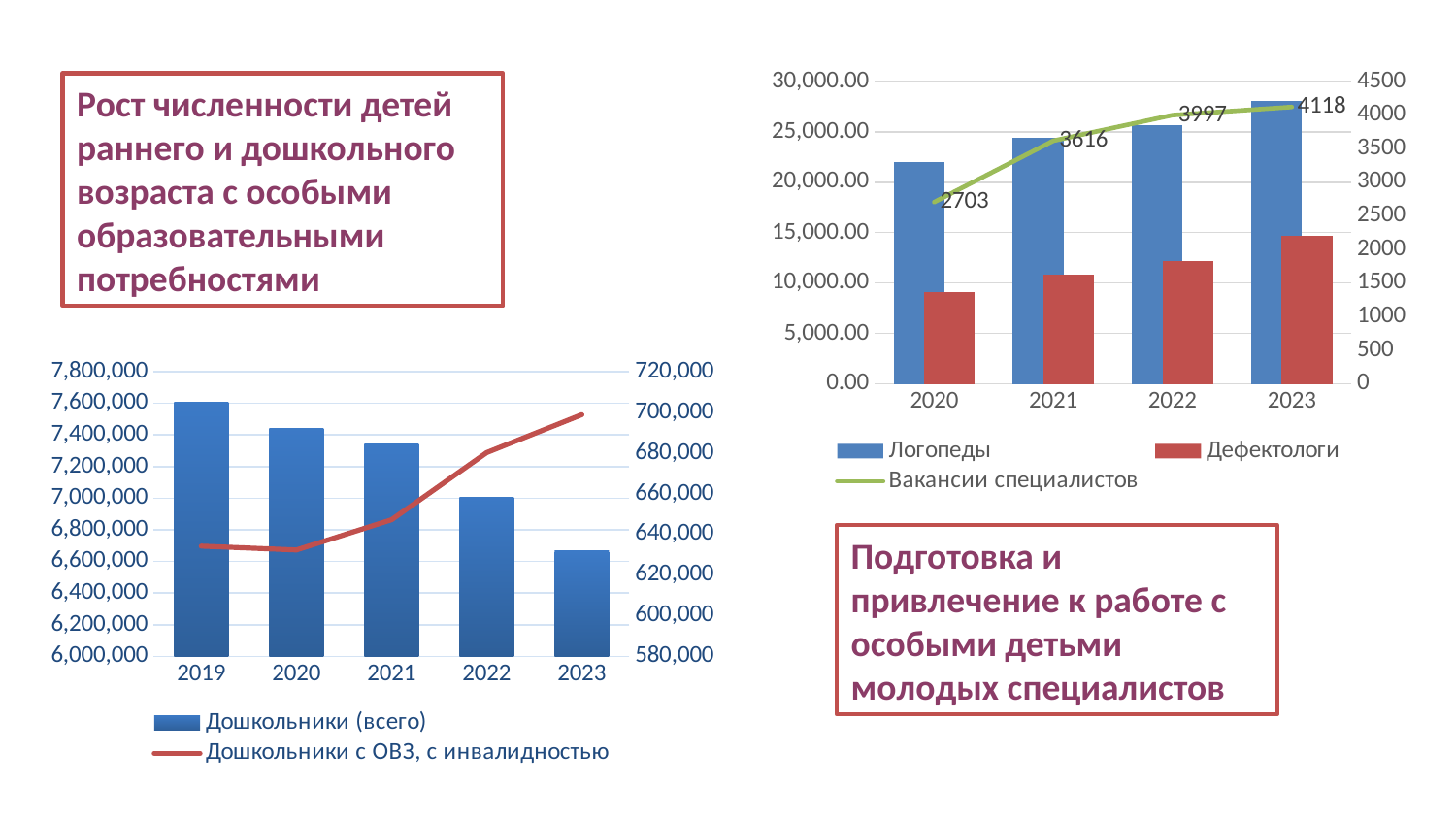
In the right chart, what is the value of Вакансии специалистов for 2021? 3616 In the left chart, do the values for Дошкольники (всего) rise or fall from 2019 to 2023? fall In the right chart, is the value for Дефектологи in 2020 greater or less than 10,000? less In the left chart, how many years are shown on the x axis? 5 In the left chart, is the value for Дошкольники (всего) in 2023 greater or less than 6,800,000? less In the right chart, by how much did Вакансии специалистов increase from 2020 to 2023? 1415 In the right chart, which year has the highest value for Вакансии специалистов? 2023 In the right chart, what is the value of Вакансии специалистов for 2023? 4118 In the right chart, is the value for Логопеды in 2020 greater or less than 20,000? greater In the right chart, what is the value of Вакансии специалистов for 2020? 2703 In the left chart, which year has the highest value for Дошкольники (всего)? 2019 In the right chart, how many series does the legend list? 3